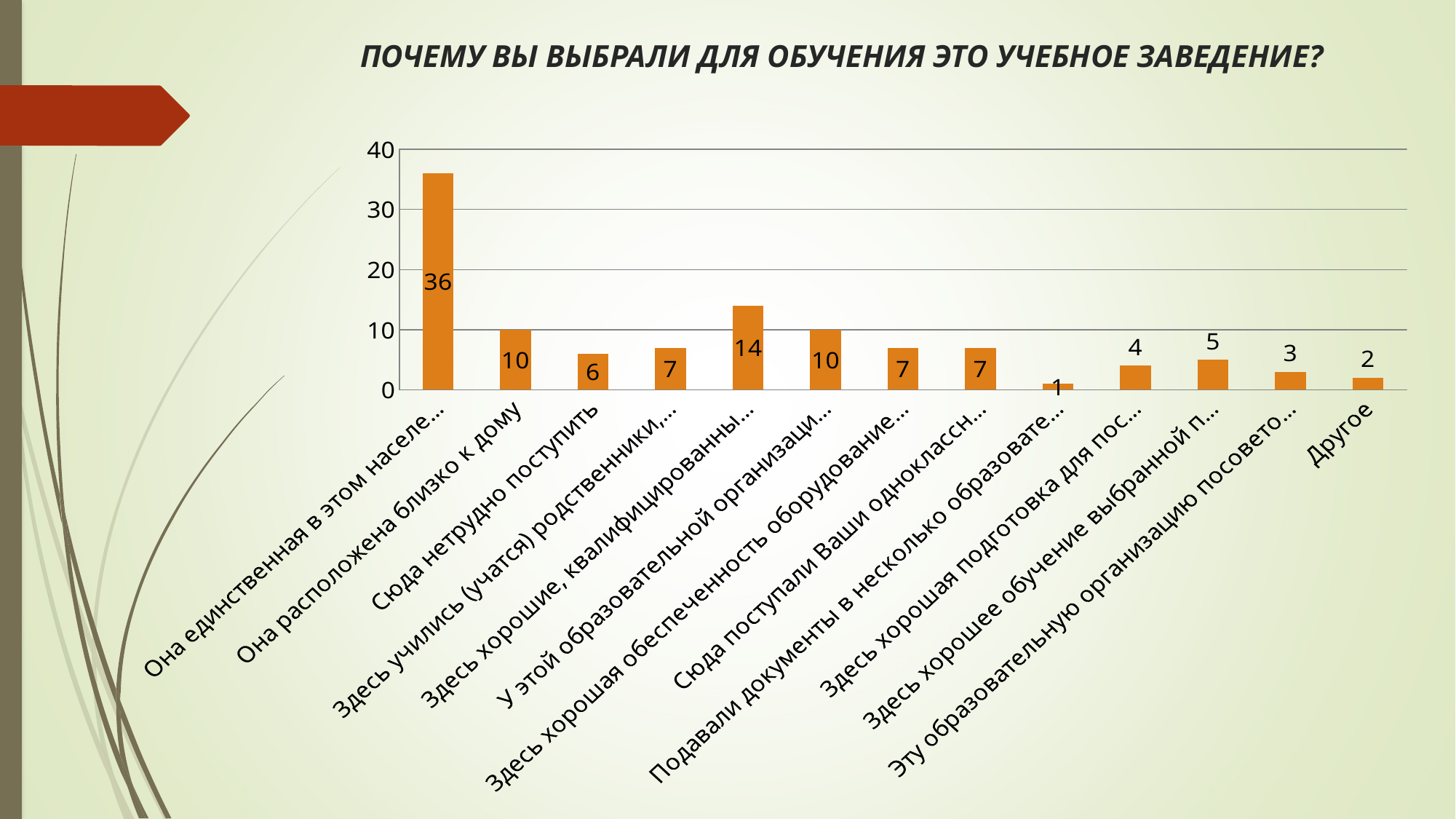
How many categories are shown on the x axis? 13 What is the value for the category whose label begins "Здесь хорошие, квалифицированны..."? 14 What type of chart is shown on the slide? bar chart Which is larger: the value for "Сюда нетрудно поступить" or the value for "Другое"? Сюда нетрудно поступить Is the value for "Она единственная в этом населе..." greater or less than 30? greater What is the value for "Сюда нетрудно поступить"? 6 What is the difference between the value for "Она единственная в этом населе..." and the value for "Она расположена близко к дому"? 26 What is the title of the chart? ПОЧЕМУ ВЫ ВЫБРАЛИ ДЛЯ ОБУЧЕНИЯ ЭТО УЧЕБНОЕ ЗАВЕДЕНИЕ? What is the value for "Другое"? 2 What is the value for "Она расположена близко к дому"? 10 Which category has the highest value? Она единственная в этом населе... Which category has the lowest value? Подавали документы в несколько образовате...